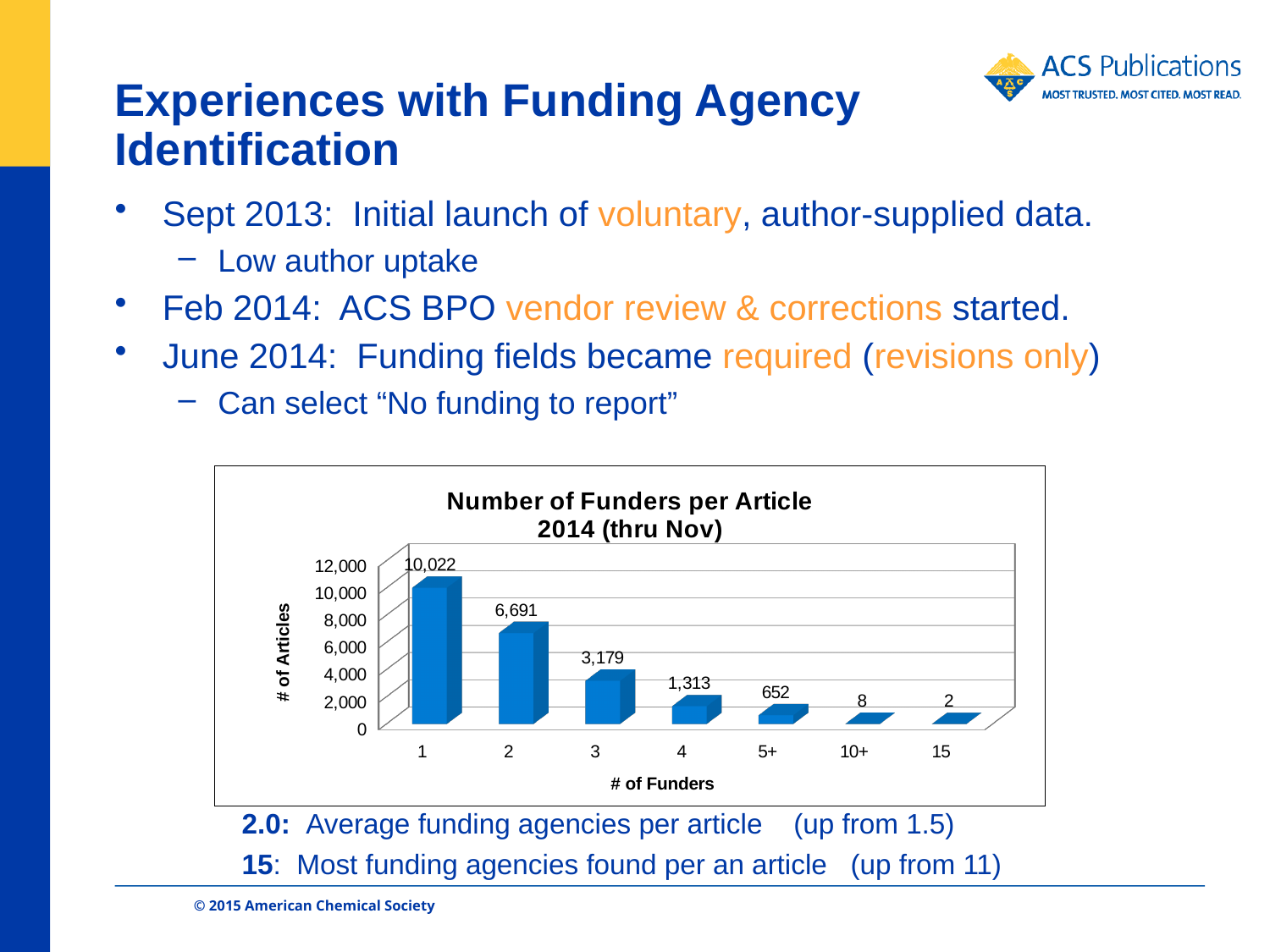
What is the number of articles with 3 funders? 3,179 What is the difference in number of articles between 1 funder and 2 funders? 3,331 What is the number of articles with 5+ funders? 652 Is the value for 2 funders greater or less than 6,000? greater Which category of # of Funders has the highest number of articles? 1 How many categories are shown on the x axis? 7 Which category of # of Funders has the lowest number of articles? 15 Which has more articles: 4 funders or 5+ funders? 4 funders What is the title of the chart? Number of Funders per Article 2014 (thru Nov) What kind of chart is shown on the slide? bar chart What is the number of articles with 1 funder? 10,022 Do the values rise or fall as the number of funders increases along the x axis? fall